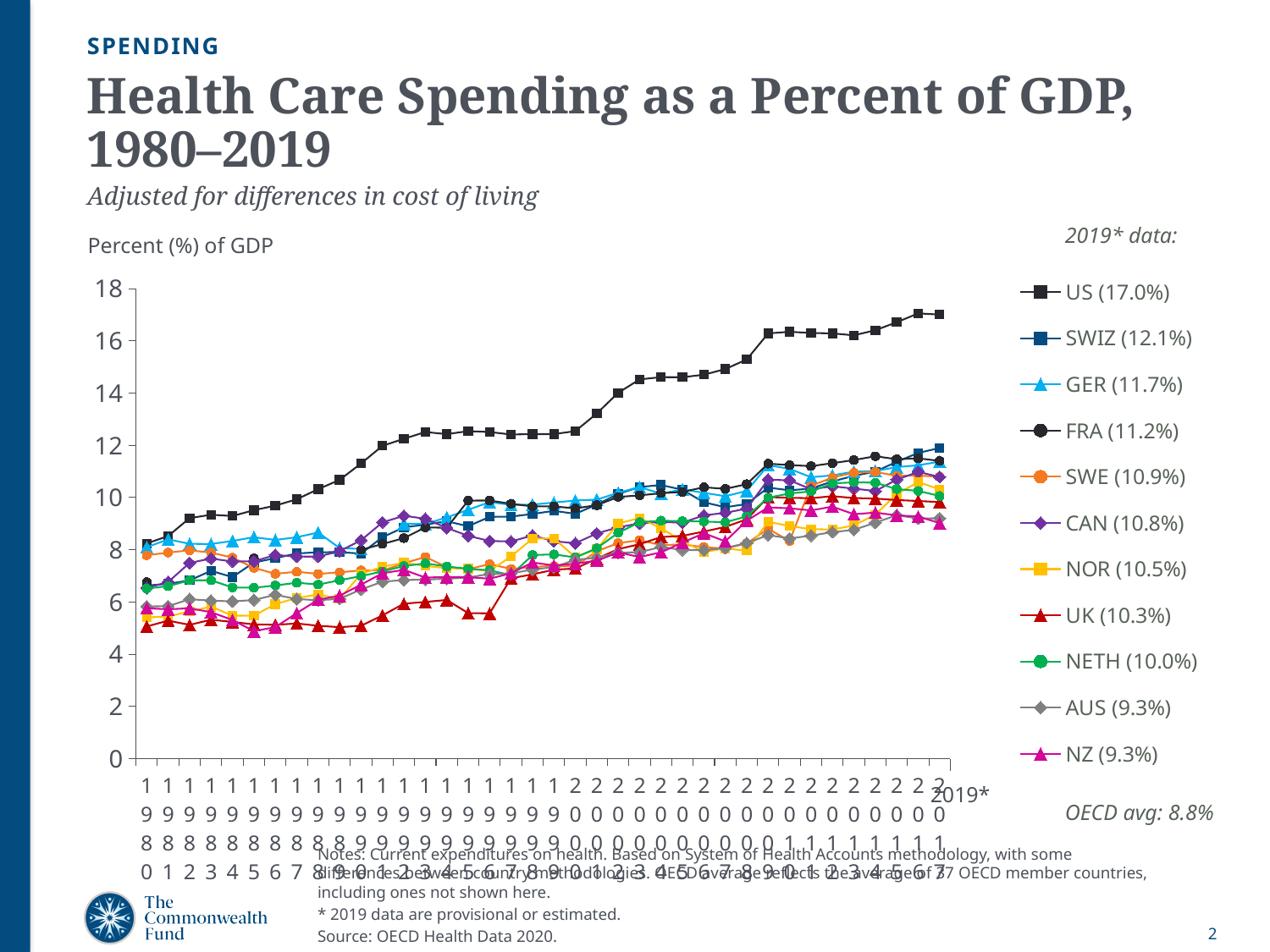
What was US health care spending as a percent of GDP in 2019? 17.0% What was Switzerland's (SWIZ) health care spending as a percent of GDP in 2019? 12.1% Does the US line rise or fall from 1980 to 2019? rises What type of chart is shown on the slide? line chart Which country had the highest health care spending as a percent of GDP in 2019? US In 2019, which had a higher value: GER or FRA? GER What is the label of the y axis? Percent (%) of GDP What was the Netherlands' (NETH) health care spending as a percent of GDP in 2019? 10.0% What is the difference between the US and SWIZ 2019 values? 4.9 percentage points Is the US value in 1980 greater or less than 10? less What is the OECD average shown on the slide? 8.8% How many countries (series) does the legend list? 11